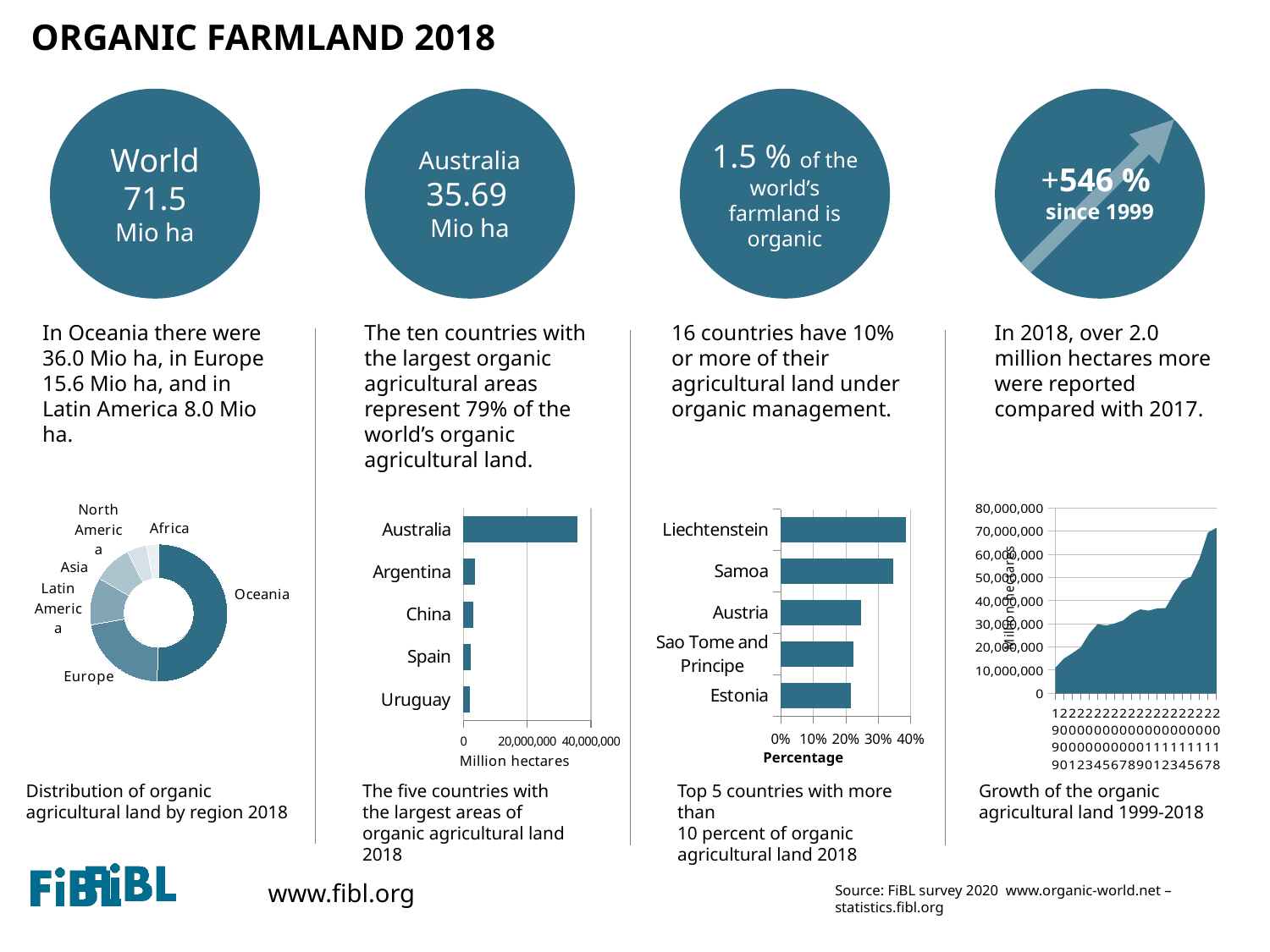
In the 'Growth of the organic agricultural land 1999-2018' chart, is the value for 2018 greater or less than 60,000,000? greater In the 'Distribution of organic agricultural land by region 2018' chart, how many regions are shown? 6 What type of chart is 'The five countries with the largest areas of organic agricultural land 2018'? bar chart In the 'Growth of the organic agricultural land 1999-2018' chart, do the values generally rise or fall over time? rise In 'The five countries with the largest areas of organic agricultural land 2018' chart, is the value for Australia greater or less than 20,000,000? greater In the 'Top 5 countries with more than 10 percent of organic agricultural land 2018' chart, is the value for Austria greater or less than 30%? less In the 'Distribution of organic agricultural land by region 2018' chart, which region has the largest share? Oceania In 'The five countries with the largest areas of organic agricultural land 2018' chart, which country has the highest value? Australia In the 'Top 5 countries with more than 10 percent of organic agricultural land 2018' chart, which is larger, Samoa or Austria? Samoa What type of chart is the 'Distribution of organic agricultural land by region 2018' chart? doughnut chart In the 'Top 5 countries with more than 10 percent of organic agricultural land 2018' chart, which country has the highest percentage? Liechtenstein